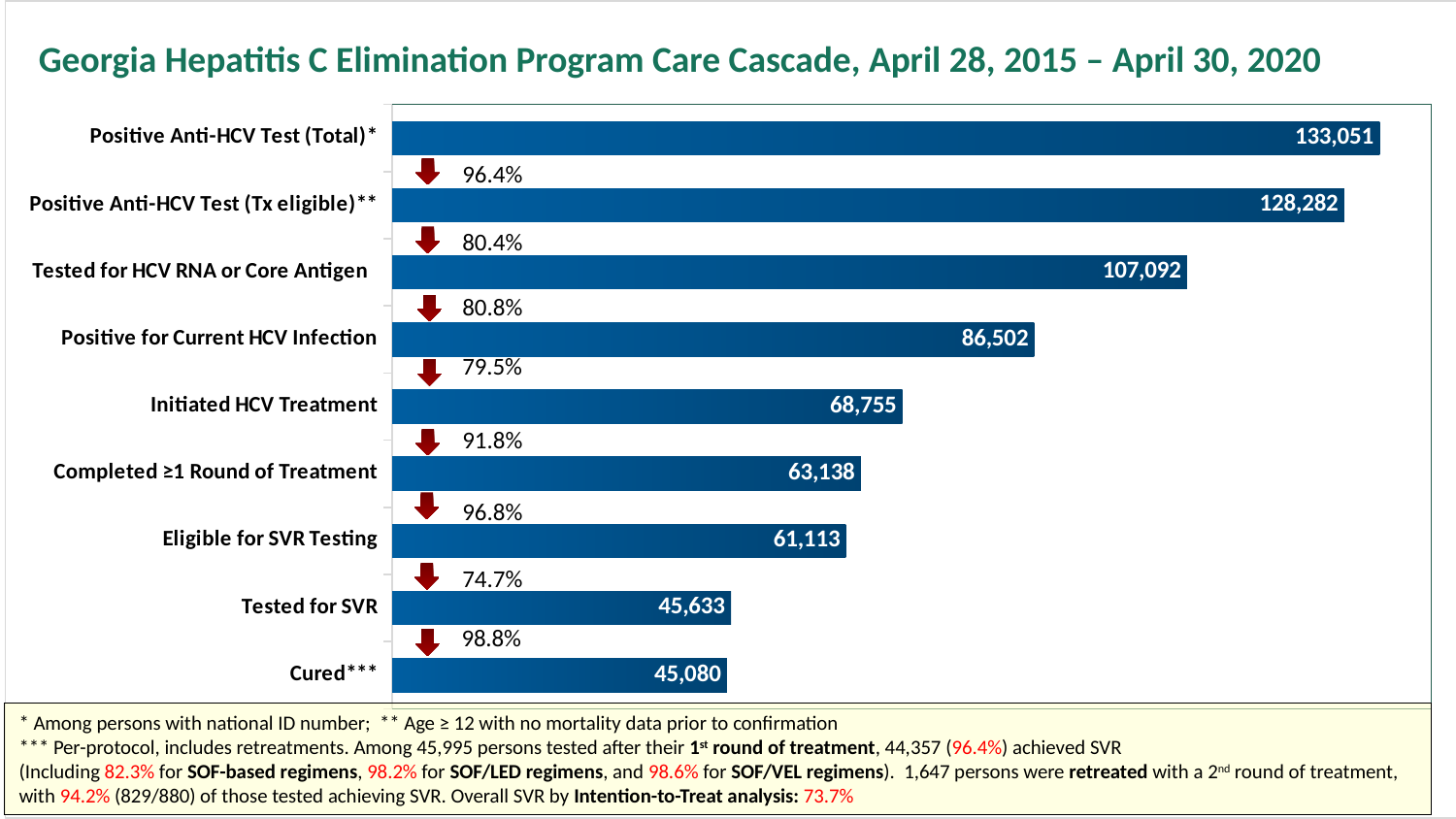
What kind of chart is shown on the slide? Bar chart What is the value for Tested for HCV RNA or Core Antigen? 107,092 What is the value for Initiated HCV Treatment? 68,755 Which category has the highest value? Positive Anti-HCV Test (Total)* What is the difference between Tested for SVR and Cured***? 553 Which category has the lowest value? Cured*** What is the difference between Positive Anti-HCV Test (Total)* and Positive Anti-HCV Test (Tx eligible)**? 4,769 What is the value for Cured***? 45,080 What is the value for Positive Anti-HCV Test (Total)*? 133,051 Which is larger, Positive for Current HCV Infection or Initiated HCV Treatment? Positive for Current HCV Infection What percentage is shown next to the arrow between Tested for SVR and Cured***? 98.8% How many categories are shown in the chart? 9